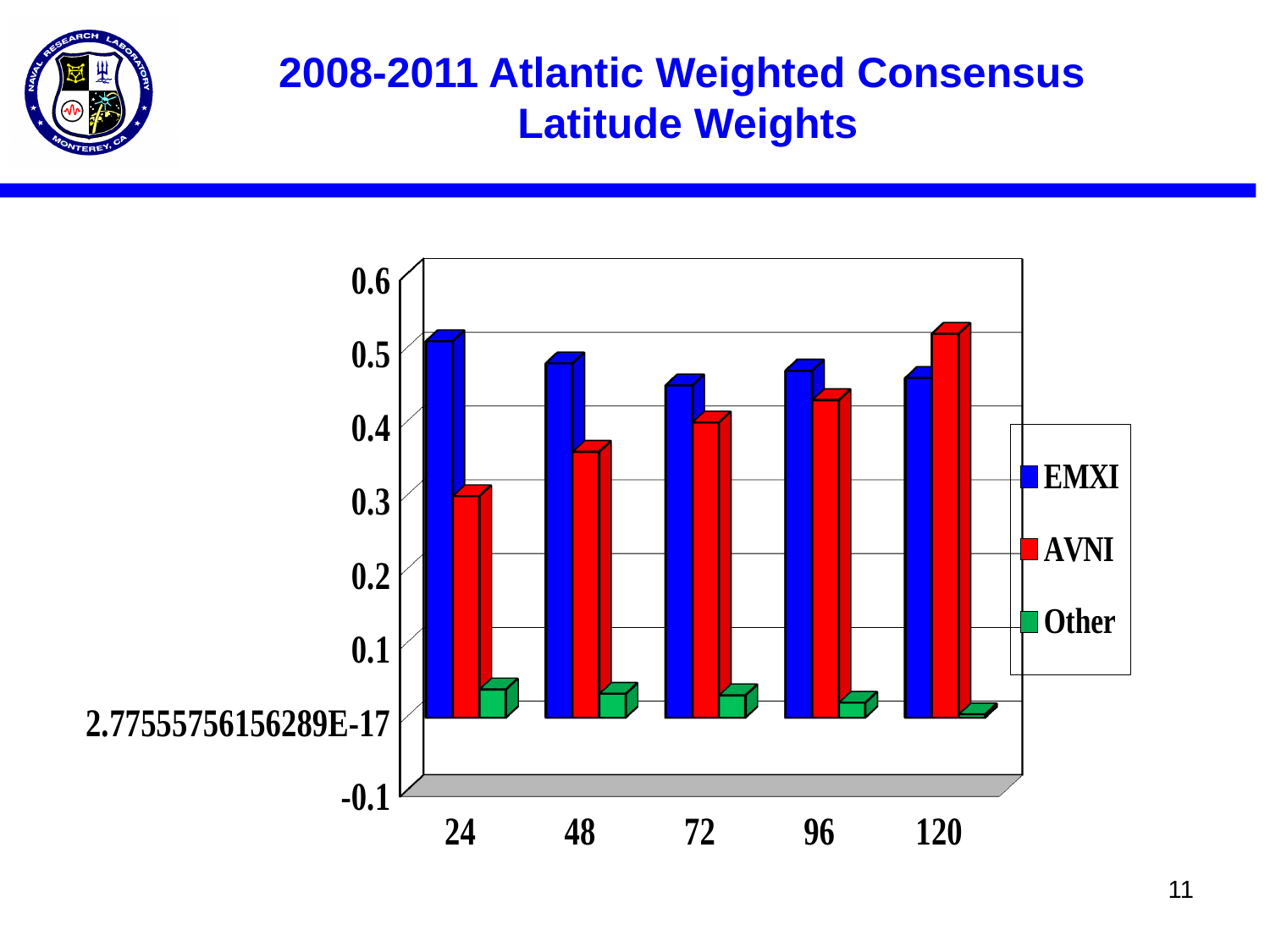
Do the AVNI weights rise or fall as the forecast hour increases from 24 to 120? rise Is the AVNI weight at forecast hour 24 greater or less than 0.4? less At which forecast hour is the AVNI weight highest? 120 Is the EMXI weight at forecast hour 24 greater or less than 0.4? greater Which colour represents the Other series in the legend? green How many categories are shown along the x axis? 5 At which forecast hour is the EMXI weight highest? 24 How many series does the legend list? 3 At which forecast hour is the AVNI weight lowest? 24 At forecast hour 120, which series has the larger weight, EMXI or AVNI? AVNI What kind of chart is shown on the slide? bar chart At forecast hour 24, which series has the larger weight, EMXI or AVNI? EMXI